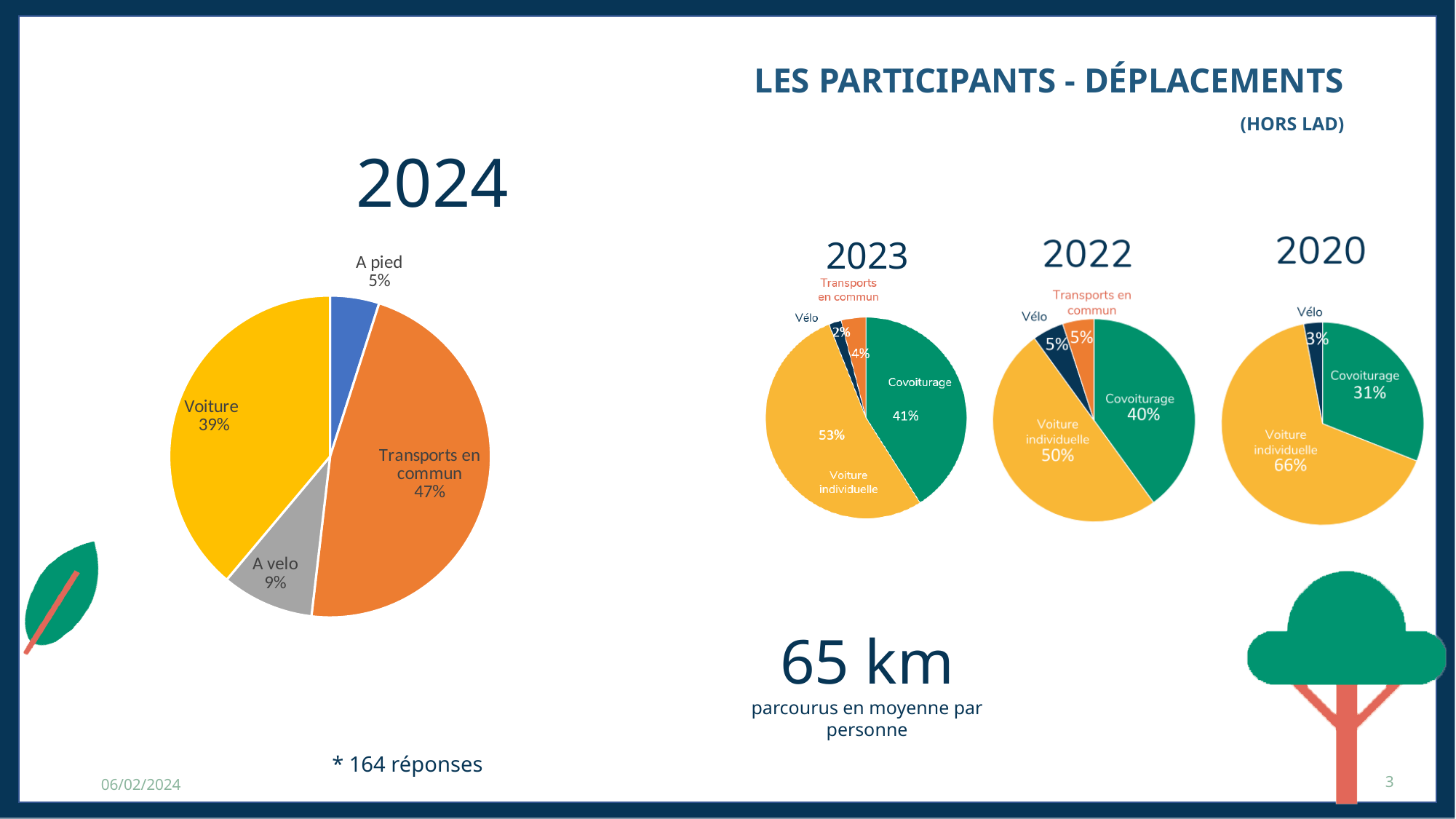
In the 2024 pie chart, which category has the smallest share? A pied In the 2023 pie chart, what share is Voiture individuelle? 53% In the 2022 pie chart, which is larger, Covoiturage or Voiture individuelle? Voiture individuelle In the 2023 pie chart, what share is Vélo? 2% In the 2024 pie chart, what is the difference between the Voiture share and the A velo share? 30% In the 2024 pie chart, what share is Voiture? 39% In the 2024 pie chart, what share is Transports en commun? 47% In the 2020 pie chart, how many slices are there? 3 In the 2024 pie chart, which category has the largest share? Transports en commun In the 2024 pie chart, how many slices are there? 4 In the 2020 pie chart, what share is Covoiturage? 31% What kind of chart is used for the 2024 data? Pie chart